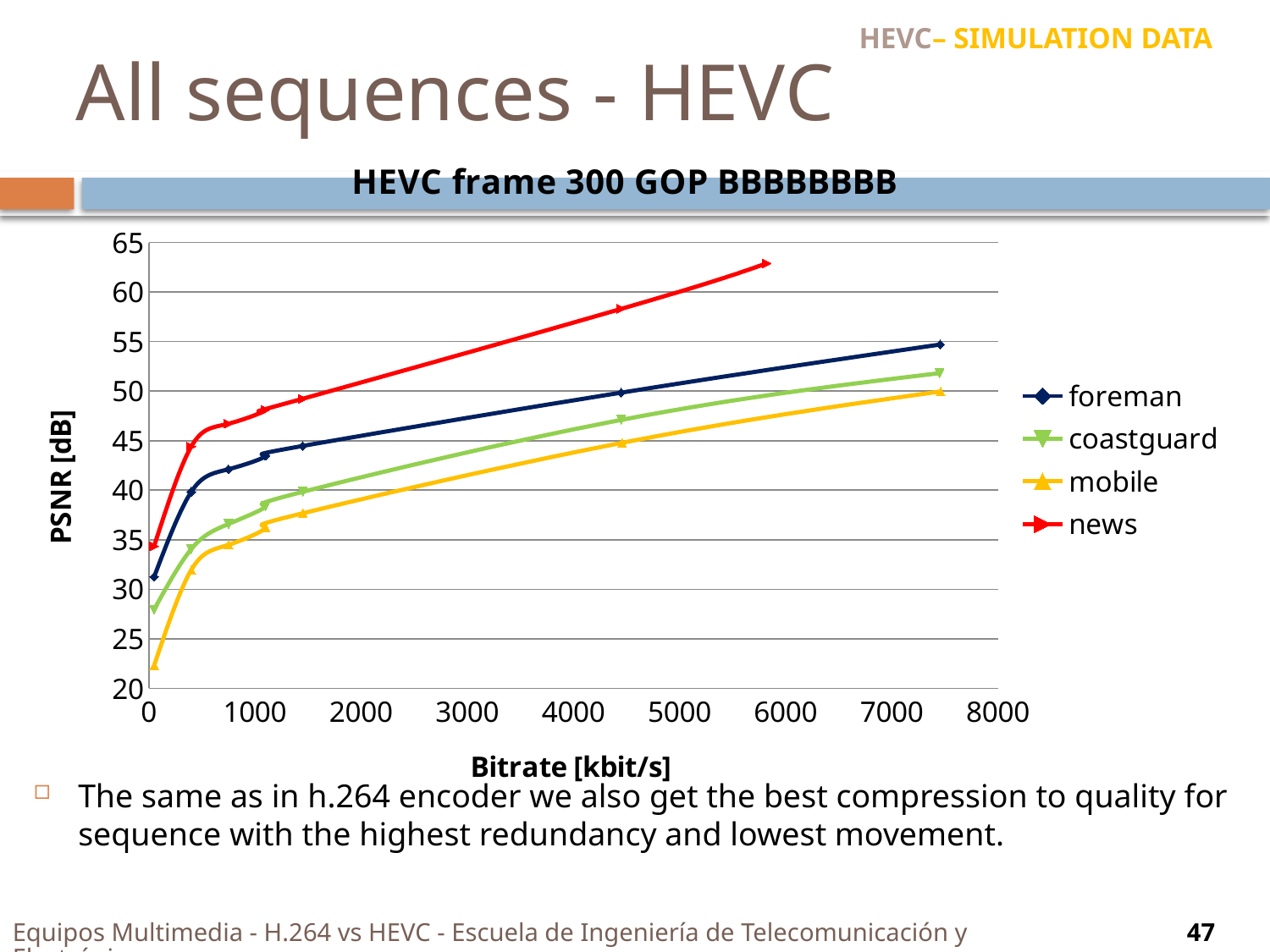
Does the PSNR of the foreman series rise or fall as bitrate increases? rise Is the lowest PSNR value of the mobile series greater or less than 25? less Which series has the lowest PSNR values across the bitrate range? mobile How many series does the legend list? 4 At a bitrate of about 4500 kbit/s, which series has the higher PSNR, coastguard or mobile? coastguard At a bitrate of about 4500 kbit/s, which series has the higher PSNR, news or foreman? news Is the highest PSNR value of the news series greater or less than 60? greater Which series reaches the highest PSNR value on the chart? news Is the PSNR of the foreman series at its highest bitrate greater or less than 50? greater What kind of chart is shown on the slide? line chart What is the title of the chart? HEVC frame 300 GOP BBBBBBBB What is the label of the vertical axis? PSNR [dB]